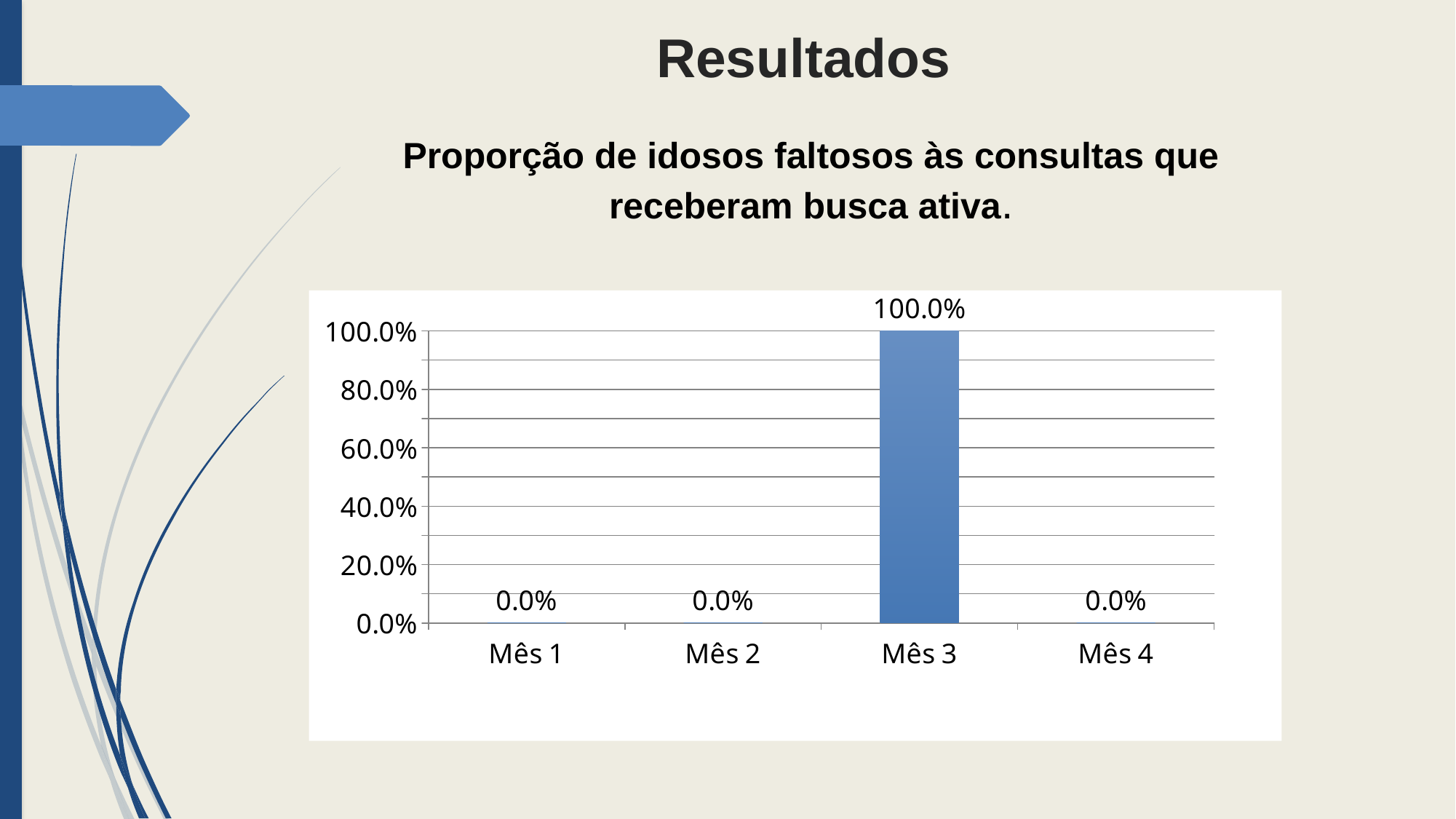
What is the title of the chart? Proporção de idosos faltosos às consultas que receberam busca ativa. Is the value for Mês 3 greater or less than 80.0%? greater What kind of chart is shown on the slide? bar chart What is the value for Mês 4? 0.0% What is the difference between the values for Mês 3 and Mês 2? 100.0% What is the value for Mês 3? 100.0% How many months have a value of 0.0%? 3 What is the highest value shown on the y axis? 100.0% Which month has the highest value? Mês 3 Which is larger, the value for Mês 3 or the value for Mês 4? Mês 3 How many months are shown on the x axis? 4 What is the value for Mês 1? 0.0%